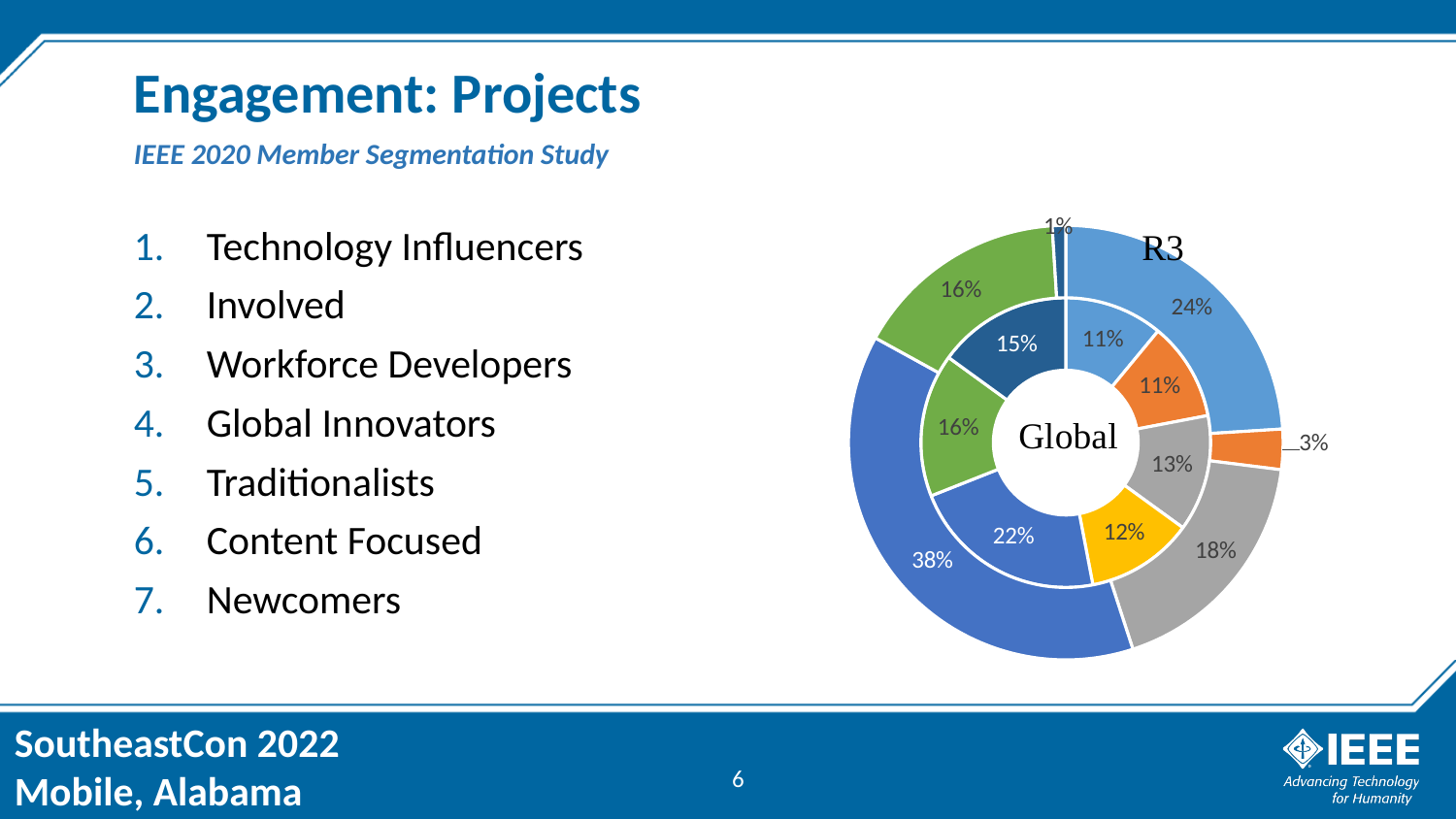
What is the smallest percentage shown in the outer R3 ring? 1% What percentage does the orange segment show in the outer R3 ring? 3% What percentage does the light blue segment show in the outer R3 ring? 24% What percentage does the green segment show in the inner Global ring? 16% What are the two rings of the doughnut chart labelled? Global and R3 Which is larger, the blue segment in the R3 ring or the blue segment in the Global ring? R3 ring What is the largest percentage shown in the inner Global ring? 22% What percentage does the gray segment show in the outer R3 ring? 18% What percentage does the yellow segment show in the inner Global ring? 12% What is the largest percentage shown in the outer R3 ring? 38% What kind of chart is shown on the slide? doughnut chart How many percentage labels are shown in the inner Global ring? 7